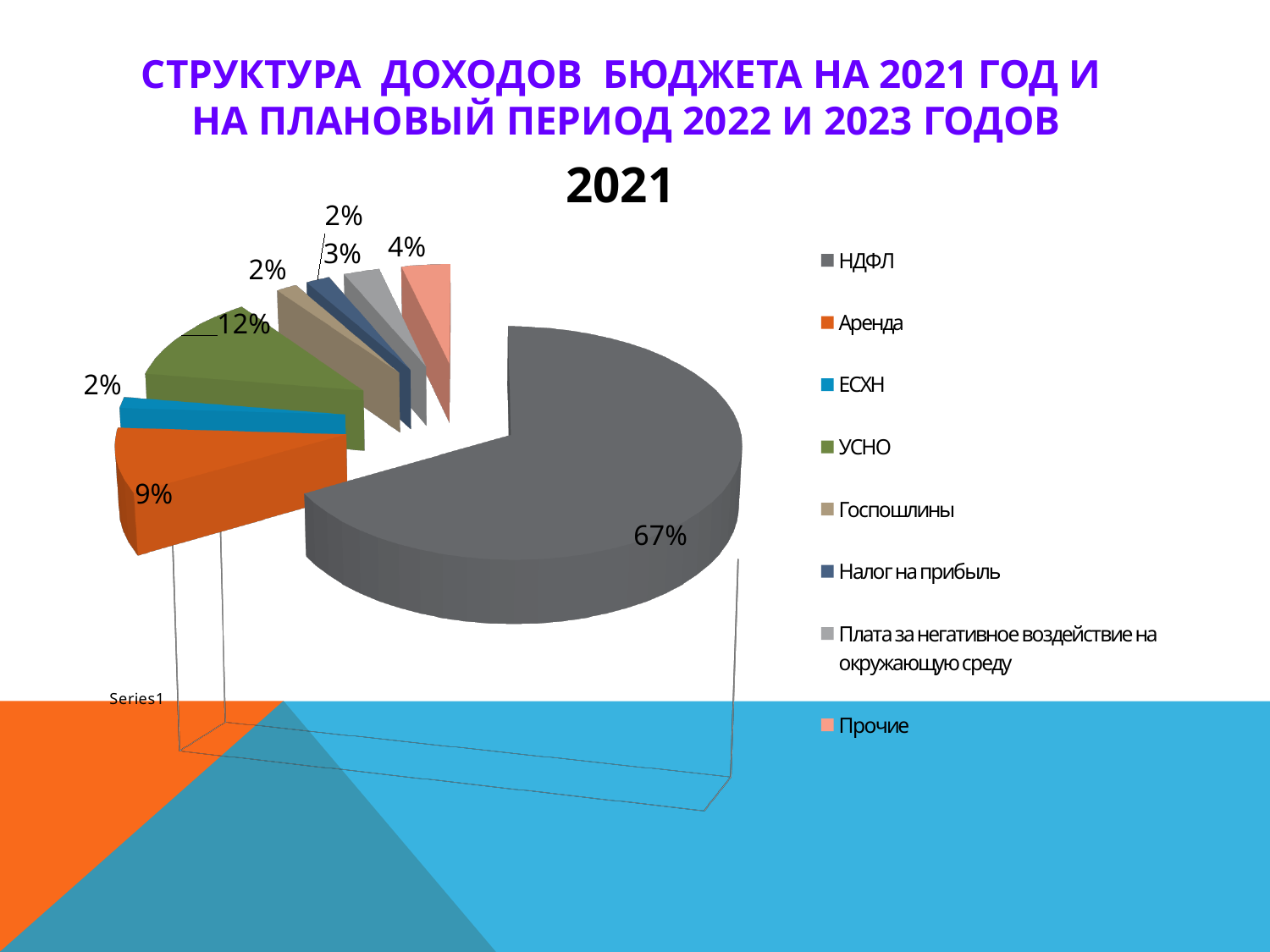
What percentage is shown for Аренда in the 2021 pie chart? 9% What type of chart is shown on the slide? Pie chart What is the title shown directly above the pie chart? 2021 What percentage is shown for Налог на прибыль in the 2021 pie chart? 2% By how many percentage points does НДФЛ exceed УСНО in the 2021 pie chart? 55 percentage points How many categories are listed in the legend of the 2021 chart? 8 Which category has the largest share in the 2021 pie chart? НДФЛ What percentage is shown for УСНО in the 2021 pie chart? 12% Which colour represents НДФЛ in the legend of the pie chart? Grey Which is larger in the 2021 pie chart, Аренда or УСНО? УСНО What share of the 2021 pie chart does НДФЛ account for? 67% What percentage is shown for Прочие in the 2021 pie chart? 4%